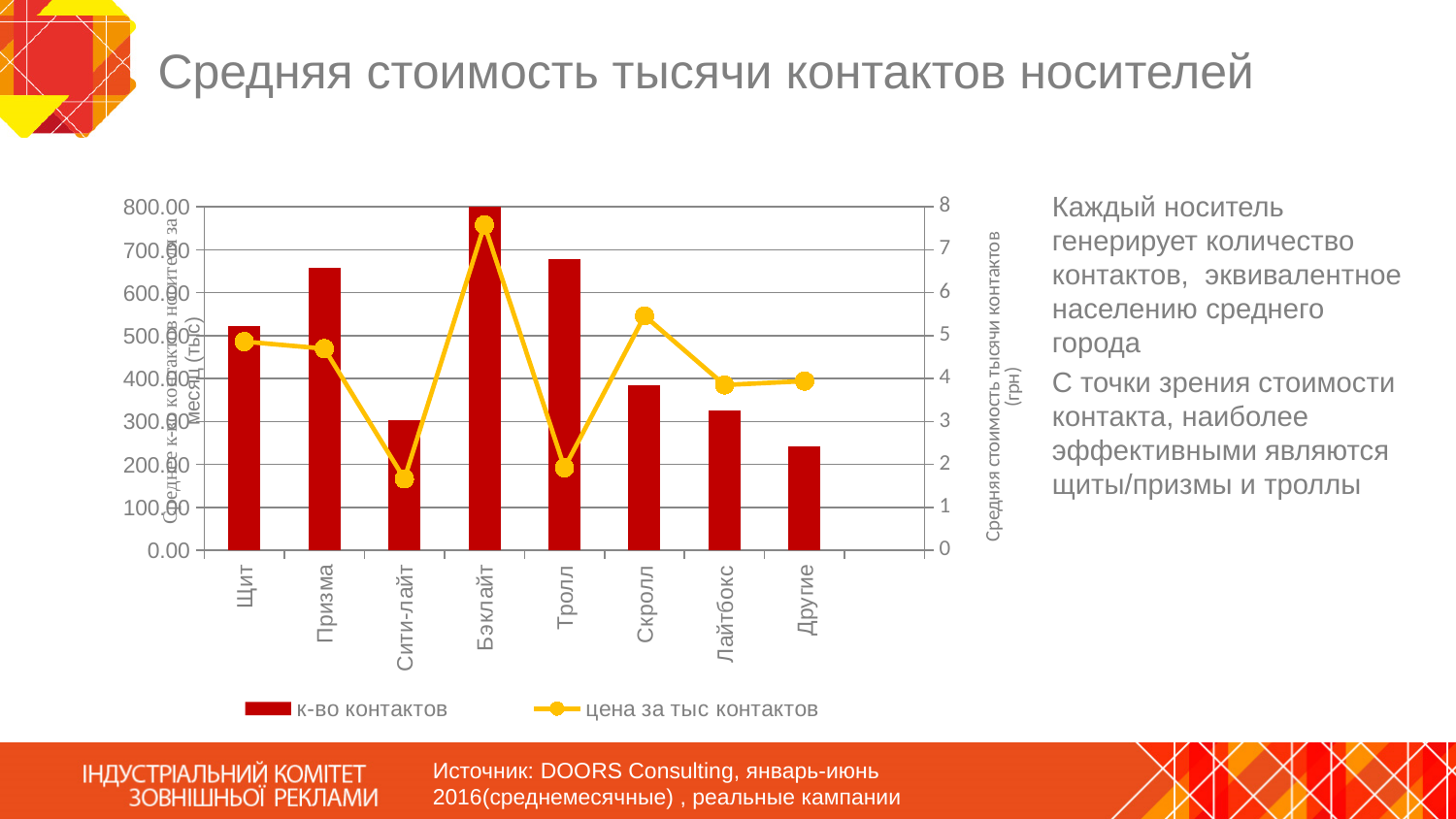
Is the к-во контактов value for Сити-лайт greater or less than 400? less How many series does the chart legend list? 2 Which series is drawn as a line with markers in the chart? цена за тыс контактов Is the к-во контактов value for Призма greater or less than 600? greater Is the цена за тыс контактов value for Скролл greater or less than 5? greater How many categories are shown on the x axis of the chart? 8 What is the title of the chart? Средняя стоимость тысячи контактов носителей Which category has the lowest bar for к-во контактов? Другие Which category has the highest value on the цена за тыс контактов line? Бэклайт Which has the larger к-во контактов bar, Щит or Призма? Призма Which category has the highest bar for к-во контактов? Бэклайт